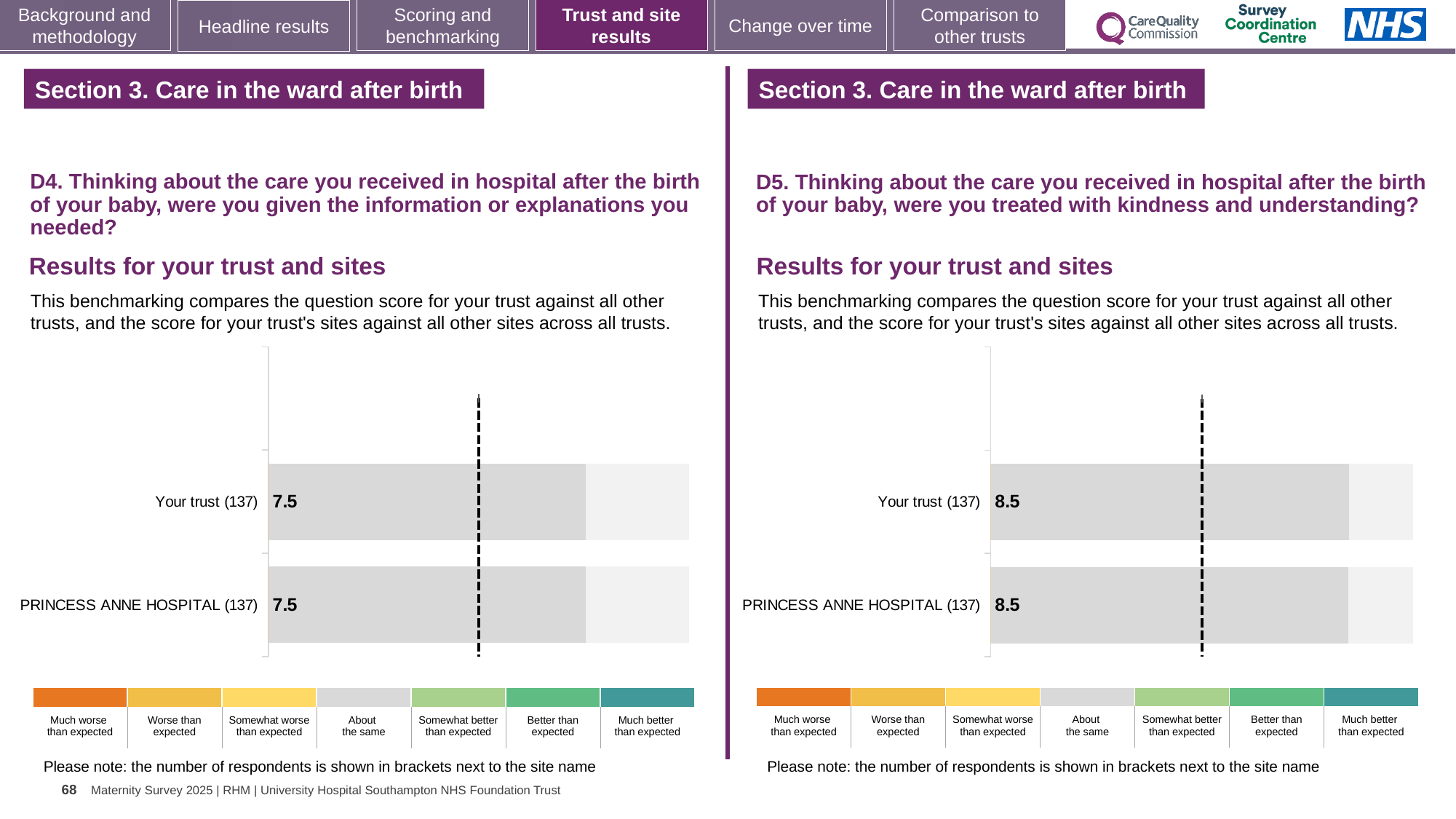
How many bars are plotted in the D4 chart on the left? 2 In the D5 chart on the right, which benchmark category does the grey colour of the bars correspond to in the key? About the same In the D4 chart on the left, what is the score for Your trust? 7.5 In the D4 chart on the left, what is the score for PRINCESS ANNE HOSPITAL? 7.5 In the D5 chart on the right, what is the score for PRINCESS ANNE HOSPITAL? 8.5 What kind of chart is used for the D4 results on the left? Bar chart In the D4 chart on the left, how many respondents are shown in brackets next to PRINCESS ANNE HOSPITAL? 137 In the D5 chart on the right, what is the score for Your trust? 8.5 How many bars are plotted in the D5 chart on the right? 2 In the D4 chart on the left, what is the difference between the score for Your trust and the score for PRINCESS ANNE HOSPITAL? 0 How many categories does the colour key below the D4 chart on the left list? 7 In the D5 chart on the right, what is the difference between the score for Your trust and the score for PRINCESS ANNE HOSPITAL? 0